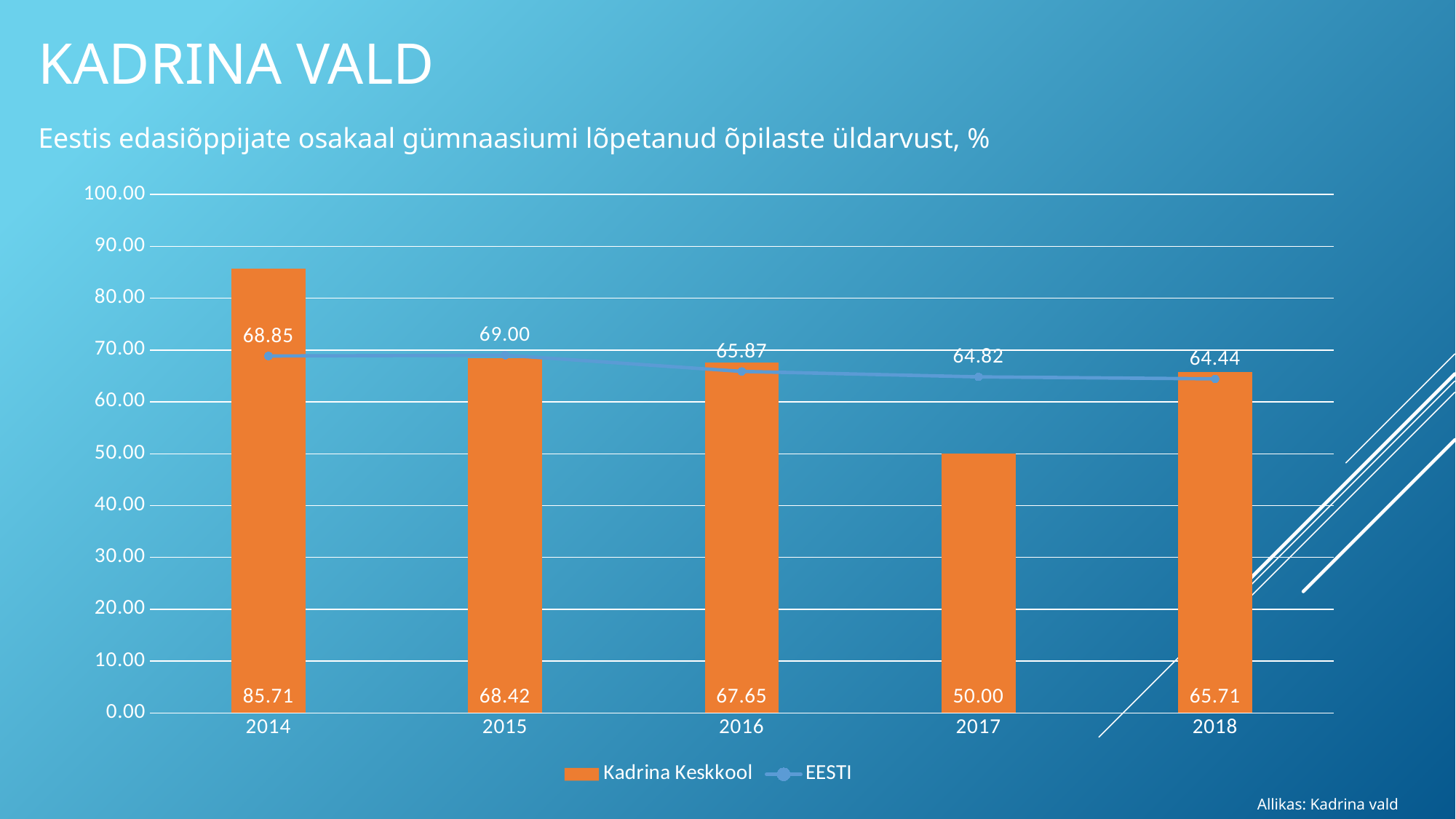
What is the value for Kadrina Keskkool in 2014? 85.71 Which series is shown as a line with markers? EESTI Does the EESTI value rise or fall from 2015 to 2018? fall How many years are shown on the x axis? 5 In which year is the EESTI value the lowest? 2018 How many series does the legend list? 2 In which year is the Kadrina Keskkool value the highest? 2014 Which is larger in 2015, the Kadrina Keskkool value or the EESTI value? EESTI What is the value for Kadrina Keskkool in 2017? 50.00 What is the value for EESTI in 2016? 65.87 What is the difference between the Kadrina Keskkool value and the EESTI value in 2014? 16.86 In which year is the Kadrina Keskkool value the lowest? 2017